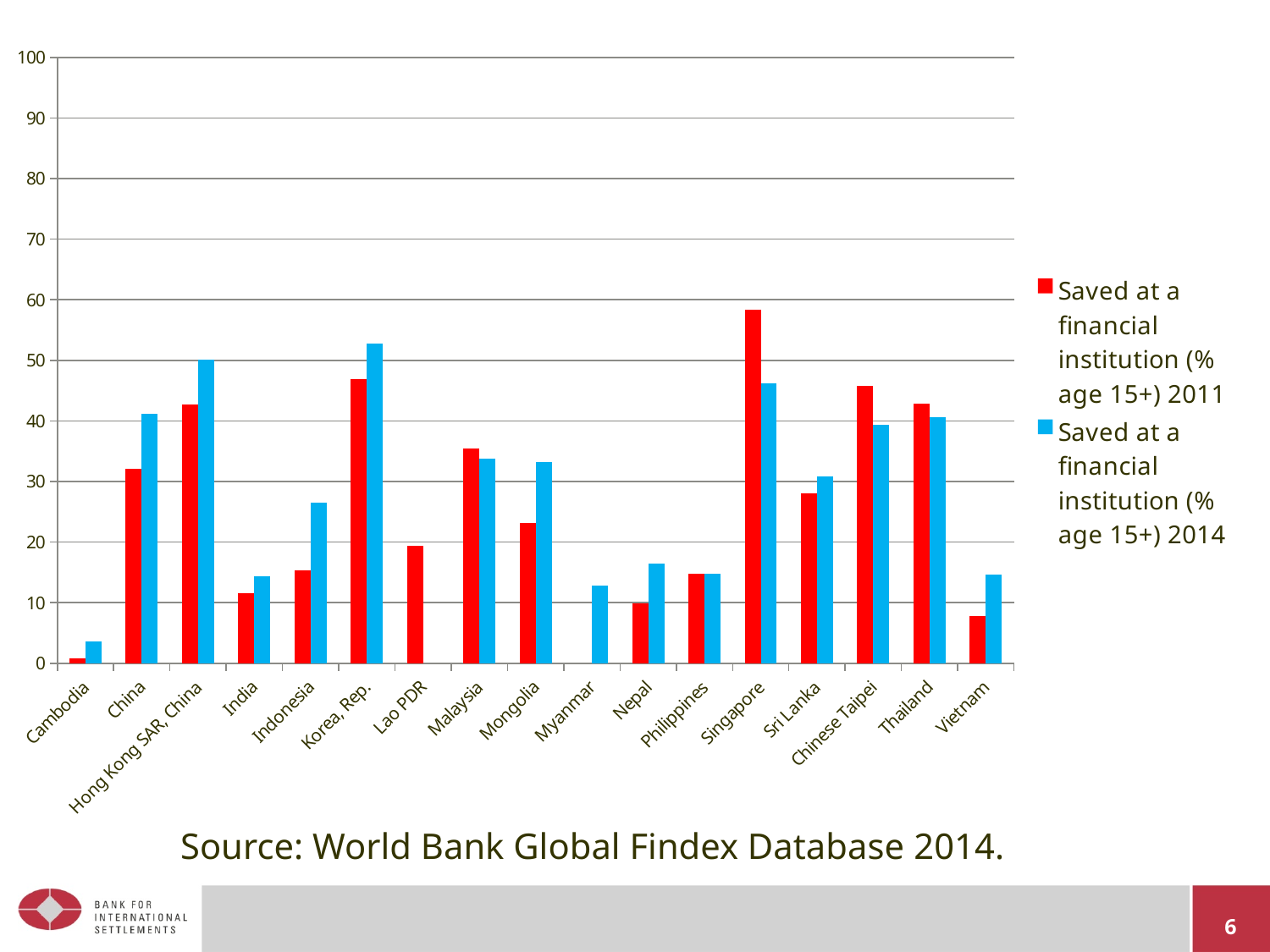
Which economy has the highest value for 'Saved at a financial institution (% age 15+) 2014'? Korea, Rep. Which colour represents 'Saved at a financial institution (% age 15+) 2014' in the legend? blue How many countries or economies are shown on the x axis? 17 Is the 2014 value for Mongolia greater or less than 30? greater For China, which is larger: the 2011 value or the 2014 value? 2014 Which economy has the highest value for 'Saved at a financial institution (% age 15+) 2011'? Singapore How many series does the legend list? 2 Is the 2011 value for Vietnam greater or less than 10? less Is the 2014 value for Korea, Rep. greater or less than 50? greater What kind of chart is shown on the slide? bar chart Which economy has the lowest value for 'Saved at a financial institution (% age 15+) 2011'? Cambodia